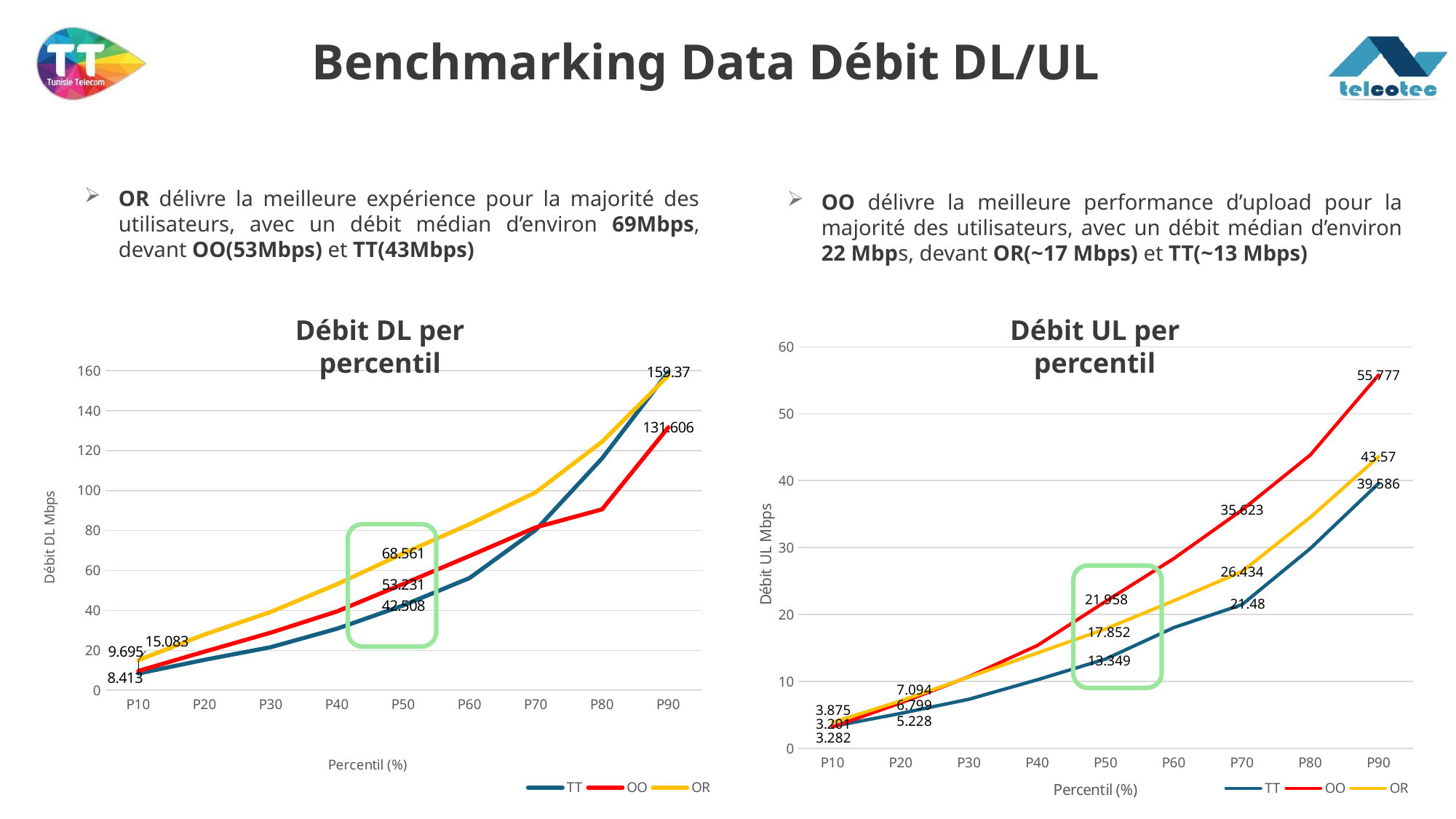
How many percentile points are plotted along the x axis of the 'Débit DL per percentil' chart? 9 In the 'Débit DL per percentil' chart, what is the difference between OR and TT at P50? 26.053 In the 'Débit DL per percentil' chart, what is the value for OR at P50? 68.561 How many series does the legend of the 'Débit UL per percentil' chart list? 3 In the 'Débit UL per percentil' chart, which series has the highest value at P90? OO What kind of chart is the 'Débit DL per percentil' chart? line chart In the 'Débit DL per percentil' chart, what is the value for TT at P50? 42.508 In the 'Débit UL per percentil' chart, what is the value for OR at P70? 26.434 In the 'Débit UL per percentil' chart, what is the difference between OO and OR at P90? 12.207 In the 'Débit DL per percentil' chart, what is the value for OO at P90? 131.606 In the 'Débit DL per percentil' chart, do the values rise or fall from P10 to P90? rise In the 'Débit UL per percentil' chart, what is the value for OO at P90? 55.777